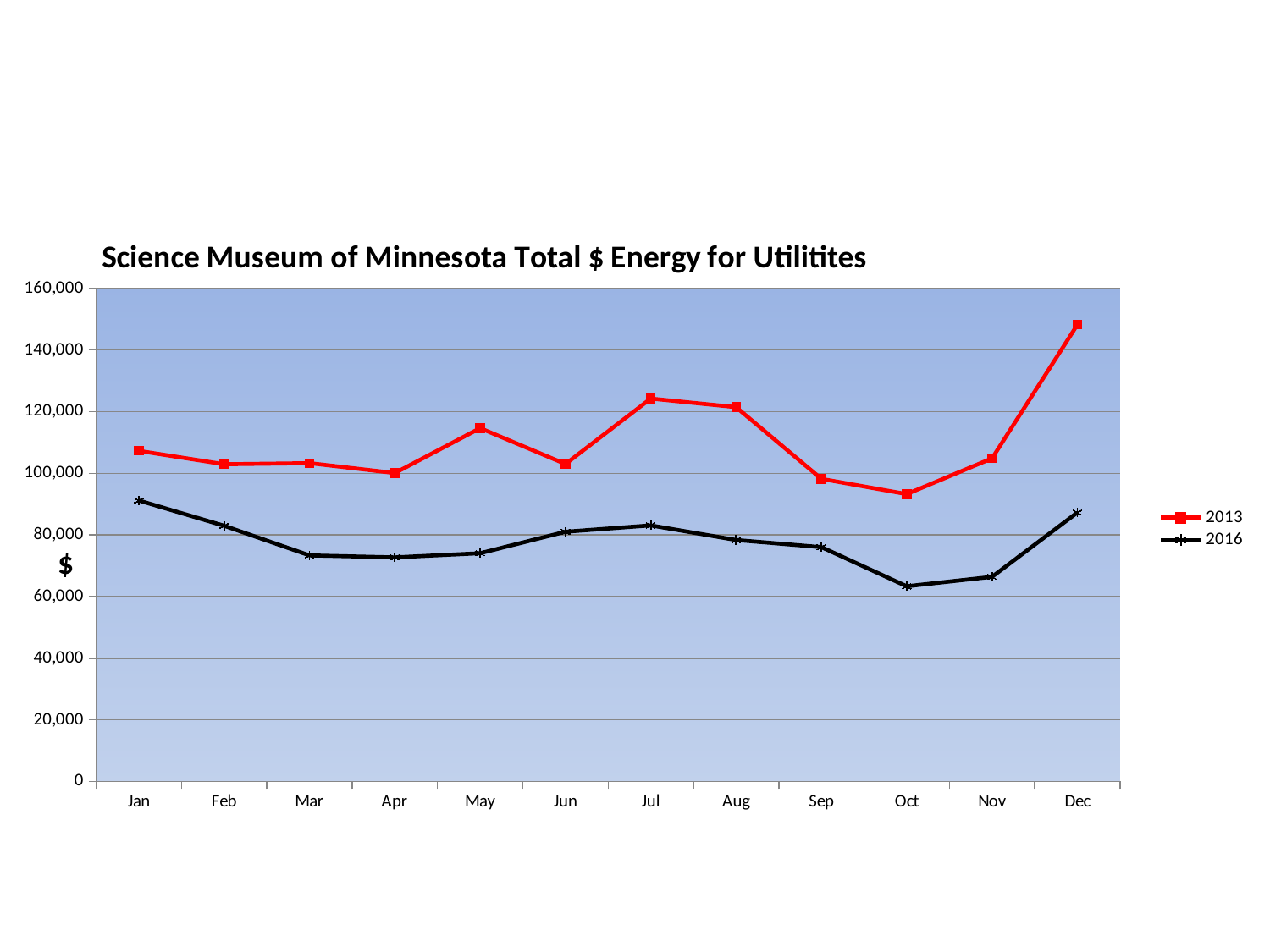
In which month is the 2016 value lowest? Oct Is the 2013 value for Dec greater or less than 140,000? greater Which series has the larger value in Dec, 2013 or 2016? 2013 What is the title of the chart? Science Museum of Minnesota Total $ Energy for Utilitites What kind of chart is shown on the slide? Line chart Does the 2016 line rise or fall from Oct to Dec? rise How many series does the legend list? 2 In which month is the 2013 value highest? Dec In which month is the 2016 value highest? Jan In which month is the 2013 value lowest? Oct How many months are plotted along the x axis? 12 Is the 2016 value for Oct greater or less than 80,000? less